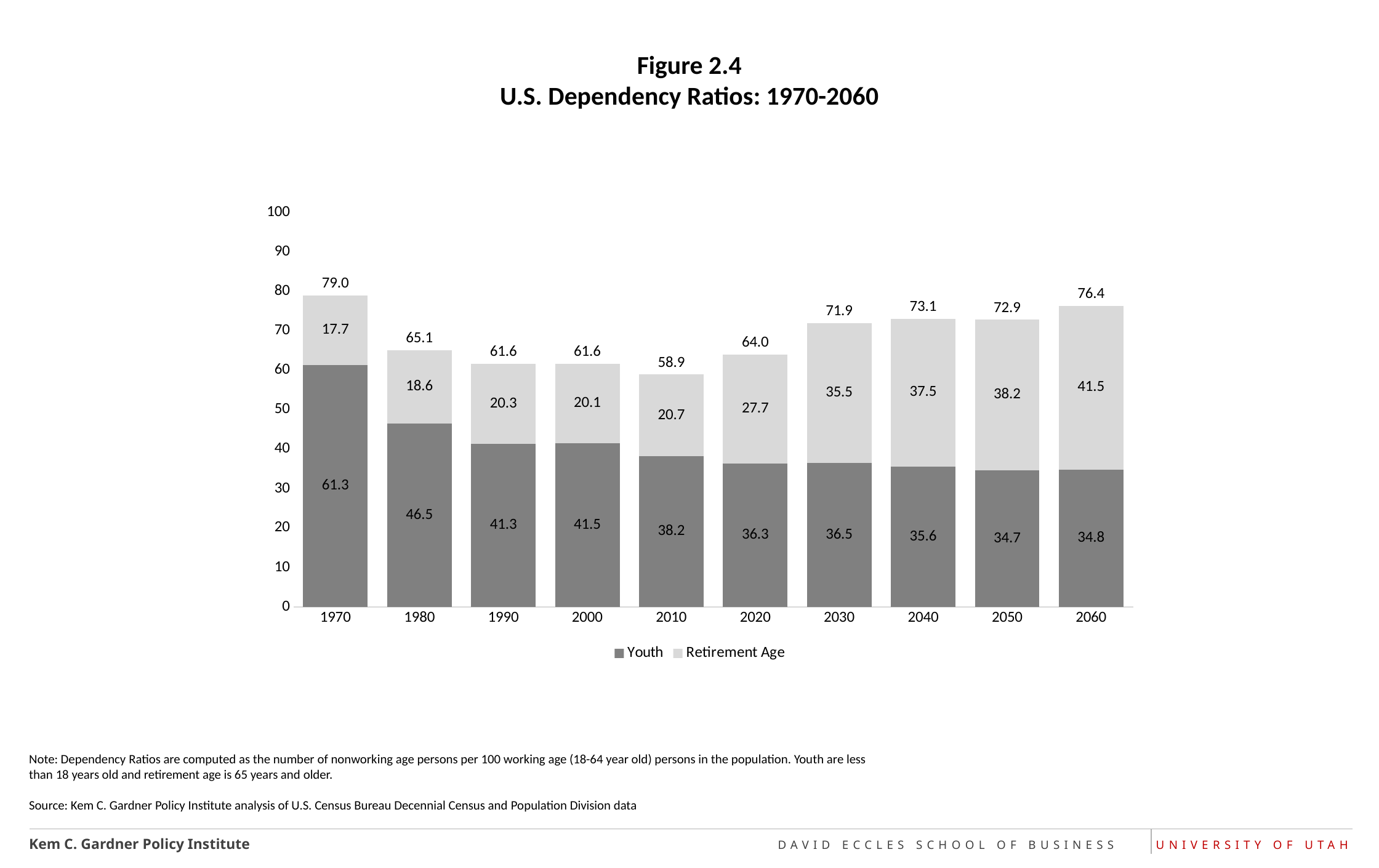
What is the Retirement Age dependency ratio for 2060? 41.5 What is the total dependency ratio shown above the bar for 2010? 58.9 What are the two series listed in the legend? Youth and Retirement Age How many series does the legend list? 2 What kind of chart is shown? Stacked bar chart Which is larger in 2020, the Youth value or the Retirement Age value? Youth What is the difference between the Retirement Age values for 2060 and 1970? 23.8 How many years are shown on the x axis? 10 What is the Youth dependency ratio for 1970? 61.3 Which year has the highest total dependency ratio? 1970 Does the Retirement Age value rise or fall from 2020 to 2060? Rise Which year has the lowest total dependency ratio? 2010